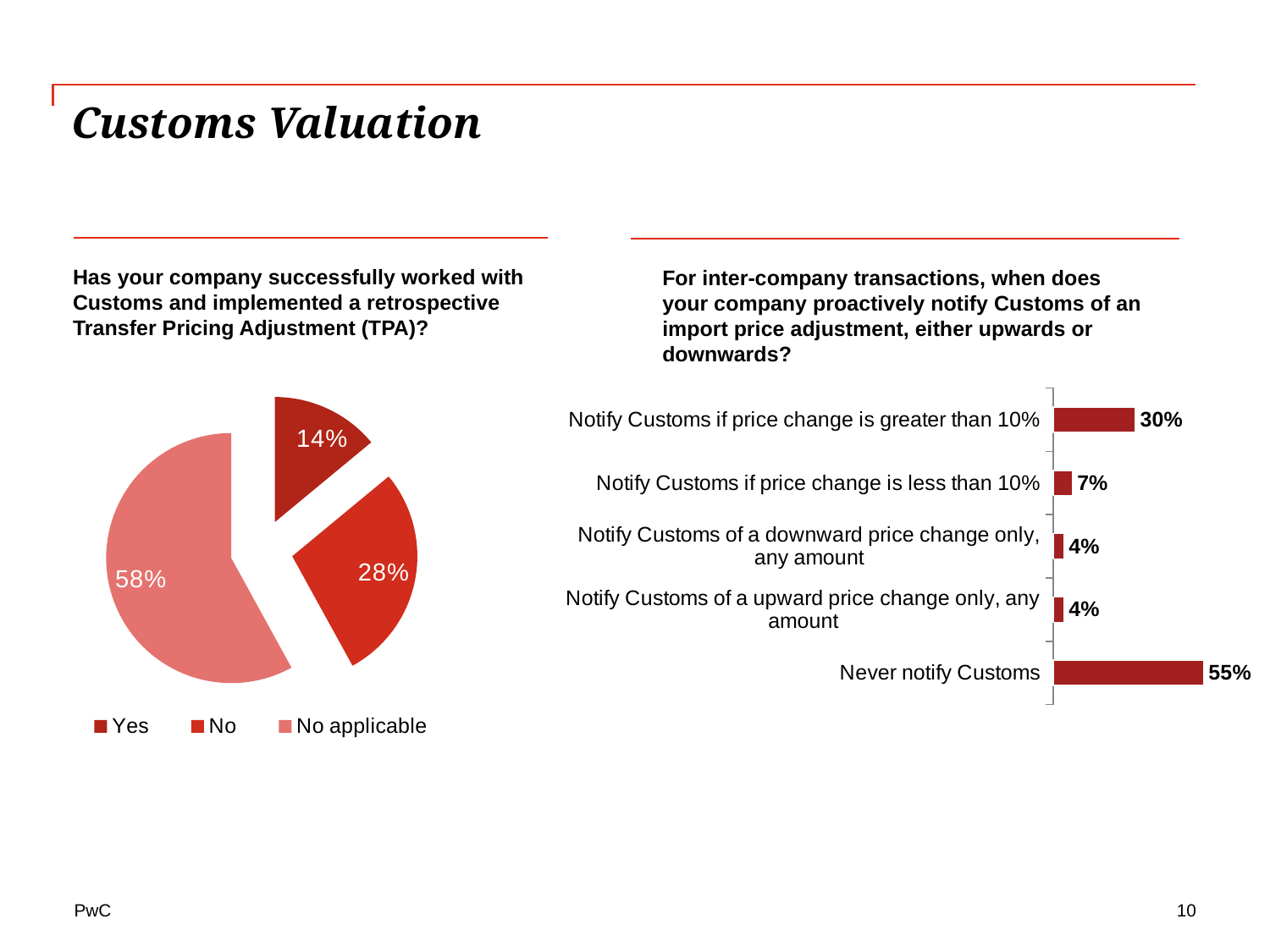
In the pie chart on the left, which response has the largest slice? No applicable In the pie chart on the left, which response has the smallest slice? Yes In the bar chart on the right, which category has the highest value? Never notify Customs In the pie chart on the left, what is the difference between the "No" and "Yes" shares? 14% How many entries does the legend of the pie chart on the left list? 3 In the bar chart on the right, how many categories are shown? 5 In the bar chart on the right, what is the value for "Never notify Customs"? 55% In the pie chart on the left, what share of respondents answered "No applicable"? 58% What kind of chart is shown on the right side of the slide? Bar chart In the bar chart on the right, what is the difference between "Never notify Customs" and "Notify Customs if price change is greater than 10%"? 25% In the pie chart on the left, what share of respondents answered "Yes"? 14% In the bar chart on the right, what is the value for "Notify Customs if price change is less than 10%"? 7%